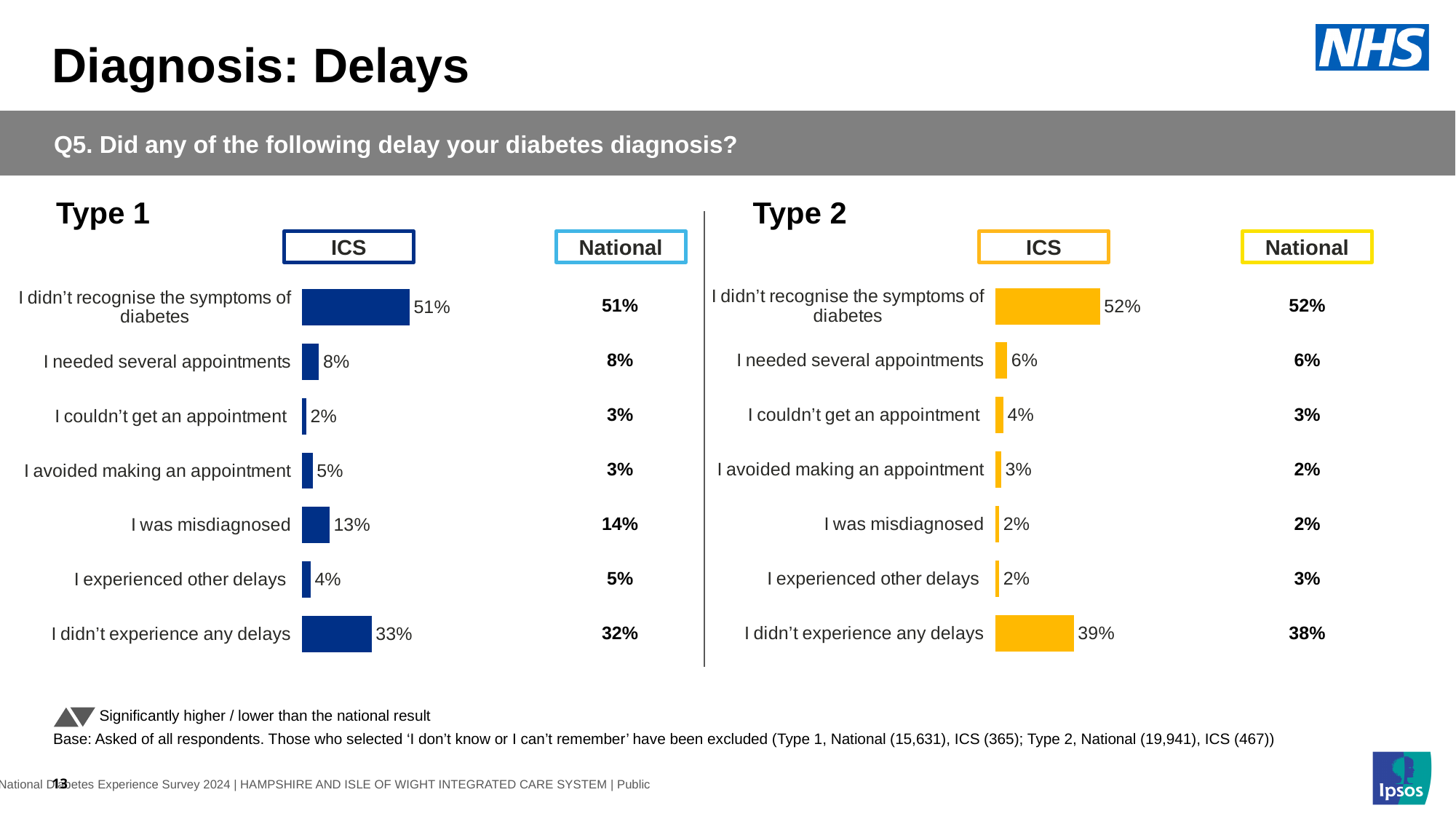
What kind of chart is used for the Type 1 ICS results? Bar chart In the Type 2 chart, what is the ICS value for 'I didn't experience any delays'? 39% In the Type 2 chart, which category has the highest ICS value? I didn't recognise the symptoms of diabetes In the Type 1 chart, what is the ICS value for 'I didn't recognise the symptoms of diabetes'? 51% In the Type 2 chart, what is the National value for 'I needed several appointments'? 6% In the Type 1 chart, which is larger: the ICS value for 'I avoided making an appointment' or the ICS value for 'I experienced other delays'? I avoided making an appointment In the Type 1 chart, what is the difference between the ICS values for 'I was misdiagnosed' and 'I needed several appointments'? 5% How many categories are shown in the Type 2 chart? 7 In the Type 1 chart, what is the National value for 'I was misdiagnosed'? 14% In the Type 1 chart, which category has the lowest ICS value? I couldn't get an appointment In the Type 1 chart, which category has the highest ICS value? I didn't recognise the symptoms of diabetes In the Type 2 chart, what is the difference between the ICS and National values for 'I didn't experience any delays'? 1%